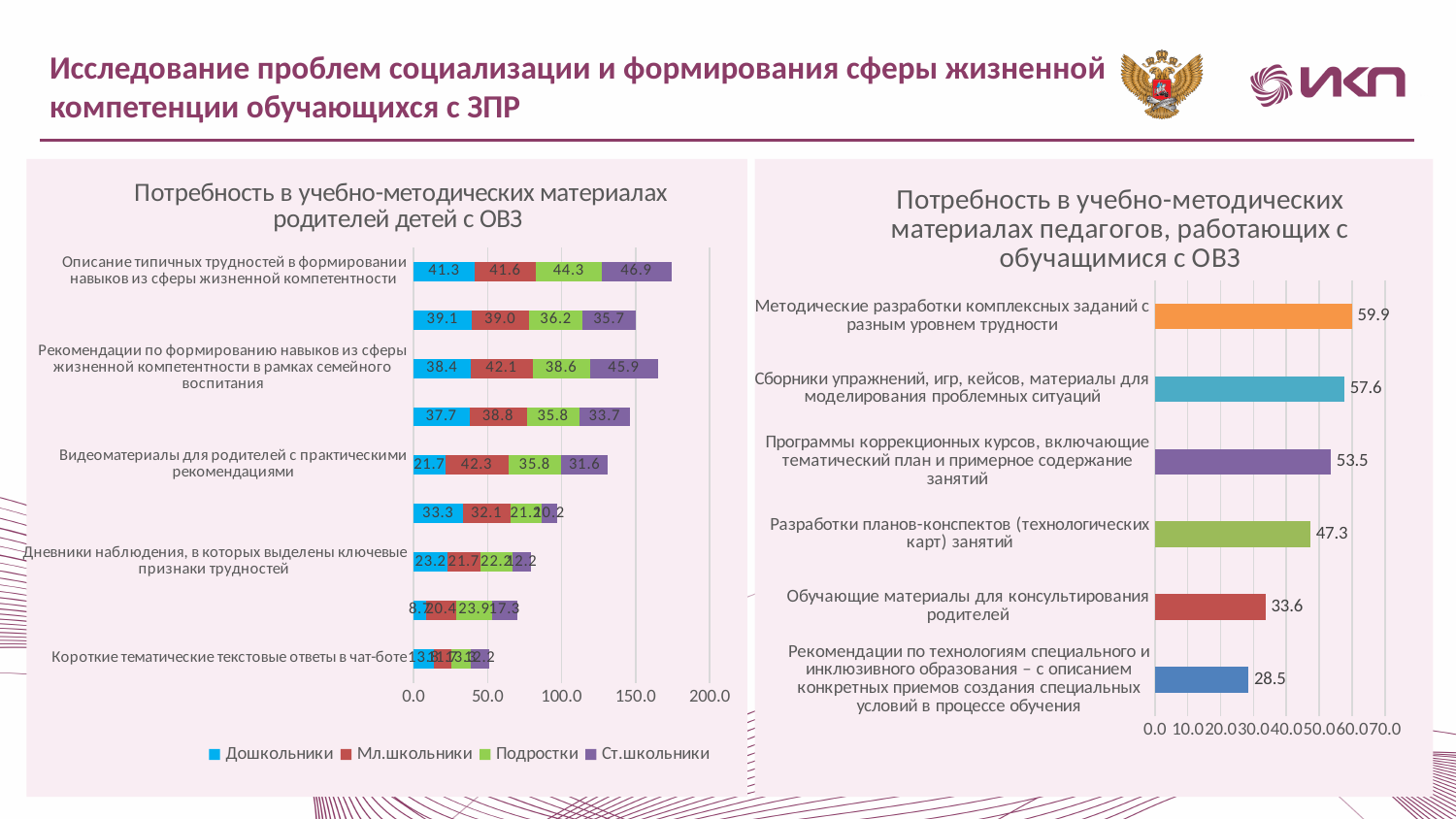
In the right chart (Потребность в учебно-методических материалах педагогов), what is the value for 'Разработки планов-конспектов (технологических карт) занятий'? 47.3 In the left chart (Потребность в учебно-методических материалах родителей детей с ОВЗ), what is the value for Дошкольники in 'Описание типичных трудностей в формировании навыков из сферы жизненной компетентности'? 41.3 In the left chart (Потребность в учебно-методических материалах родителей детей с ОВЗ), what is the total of the stacked bar for 'Описание типичных трудностей в формировании навыков из сферы жизненной компетентности'? 174.1 In the right chart (Потребность в учебно-методических материалах педагогов), which category has the lowest value? Рекомендации по технологиям специального и инклюзивного образования – с описанием конкретных приемов создания специальных условий в процессе обучения In the right chart (Потребность в учебно-методических материалах педагогов), what is the value for 'Методические разработки комплексных заданий с разным уровнем трудности'? 59.9 In the right chart (Потребность в учебно-методических материалах педагогов), which category has the highest value? Методические разработки комплексных заданий с разным уровнем трудности In the left chart (Потребность в учебно-методических материалах родителей детей с ОВЗ), for 'Видеоматериалы для родителей с практическими рекомендациями', which is larger: Дошкольники or Мл.школьники? Мл.школьники How many categories are shown in the right chart (Потребность в учебно-методических материалах педагогов)? 6 In the left chart (Потребность в учебно-методических материалах родителей детей с ОВЗ), what is the value for Ст.школьники in 'Рекомендации по формированию навыков из сферы жизненной компетентности в рамках семейного воспитания'? 45.9 What kind of chart is the right chart (Потребность в учебно-методических материалах педагогов)? Bar chart In the right chart (Потребность в учебно-методических материалах педагогов), what is the difference between 'Сборники упражнений, игр, кейсов, материалы для моделирования проблемных ситуаций' and 'Обучающие материалы для консультирования родителей'? 24.0 How many series does the legend of the left chart (Потребность в учебно-методических материалах родителей детей с ОВЗ) list? 4